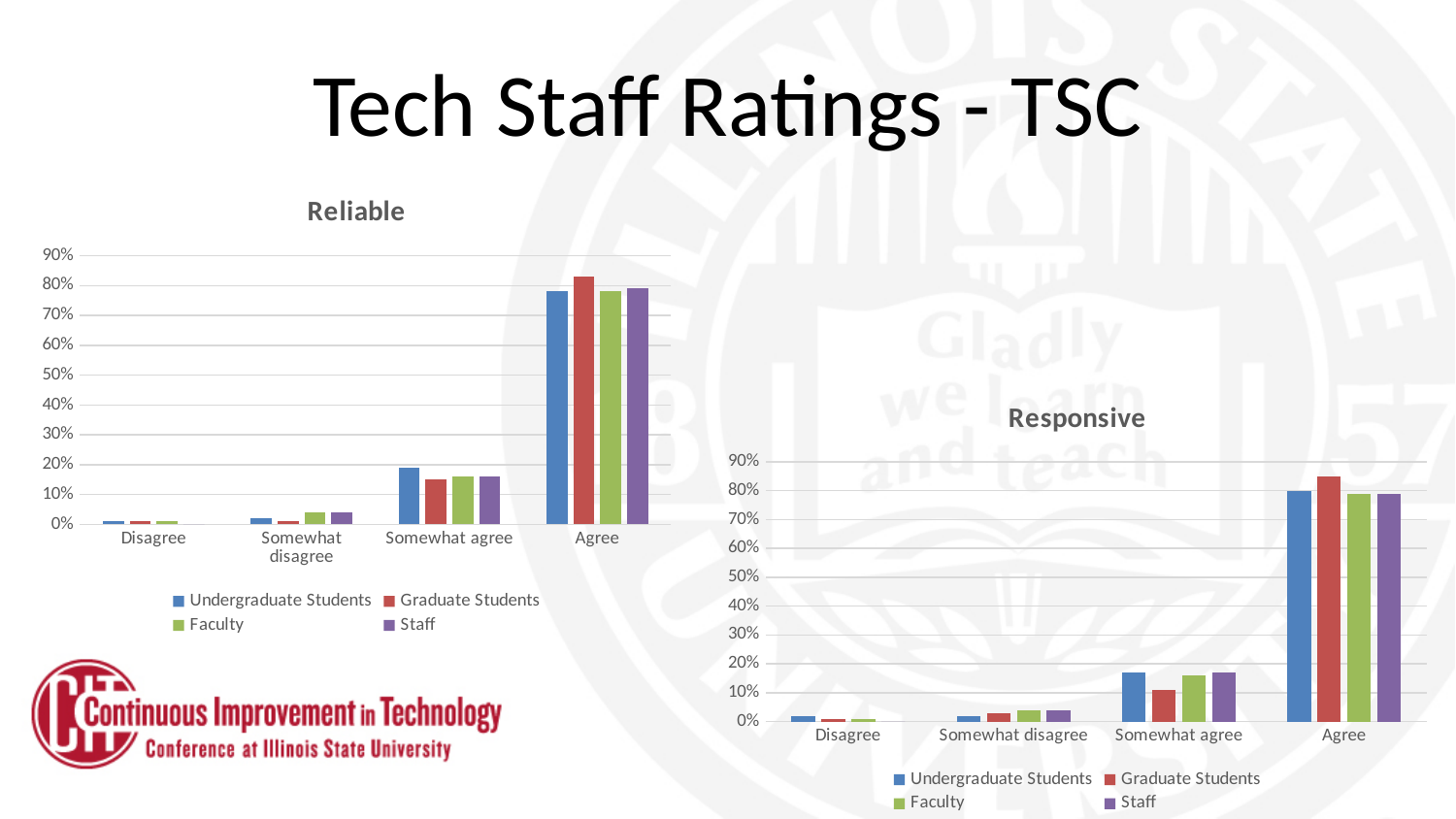
In the "Responsive" chart, is the value for Graduate Students in the Somewhat agree category greater or less than 20%? less In the "Reliable" chart, is the value for Undergraduate Students in the Somewhat agree category greater or less than 10%? greater What are the titles of the two charts on the slide? Reliable and Responsive In the "Reliable" chart, which series has the highest value for Agree? Graduate Students In the "Responsive" chart, do the values for Undergraduate Students rise or fall moving from Disagree to Agree along the x axis? rise In the "Reliable" chart, is the value for Graduate Students in the Agree category greater or less than 80%? greater In the "Responsive" chart, which series has the highest value for Agree? Graduate Students In the "Responsive" chart, which is larger for Somewhat agree: Undergraduate Students or Graduate Students? Undergraduate Students What kind of chart is the "Reliable" chart? bar chart How many series does the legend of the "Reliable" chart list? 4 How many categories are shown on the x axis of the "Responsive" chart? 4 In the "Reliable" chart, which is larger for Agree: Graduate Students or Undergraduate Students? Graduate Students